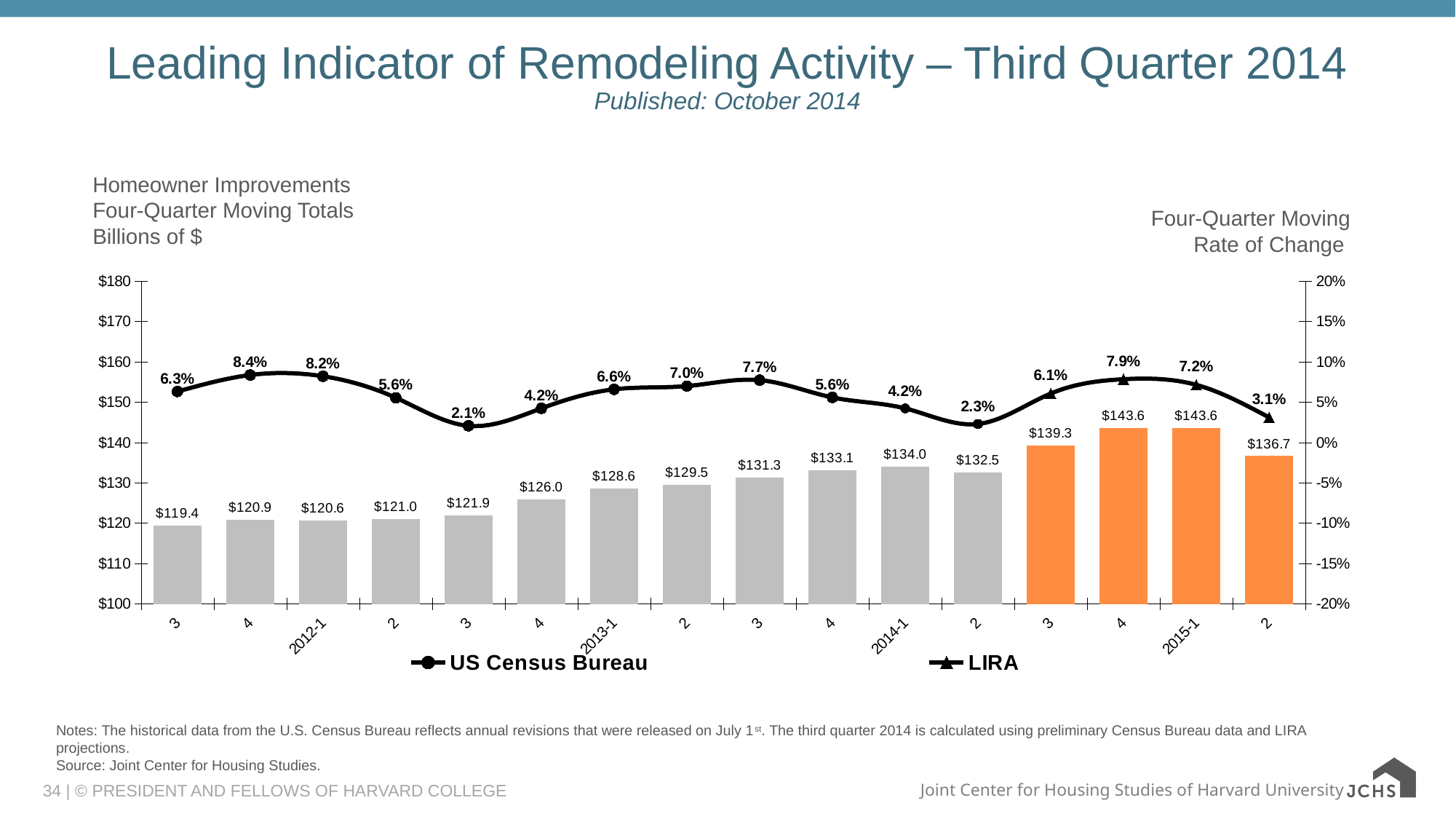
What rate of change is shown for 2013-1? 6.6% What is the four-quarter moving total shown for 2014-1? $134.0 Which has the larger four-quarter moving total, 2015-1 or 2014-1? 2015-1 How many series does the legend list? 2 What is the lowest four-quarter moving total shown on the chart? $119.4 What is the difference between the four-quarter moving totals for 2014-1 and 2013-1? $5.4 What rate of change is shown for 2015-1? 7.2% How many bars are plotted on the chart? 16 What is the highest rate of change shown on the chart? 8.4% Which series does the legend show with triangle markers? LIRA What is the four-quarter moving total shown for 2012-1? $120.6 What is the four-quarter moving total shown for the last bar on the right (labelled 2, after 2015-1)? $136.7